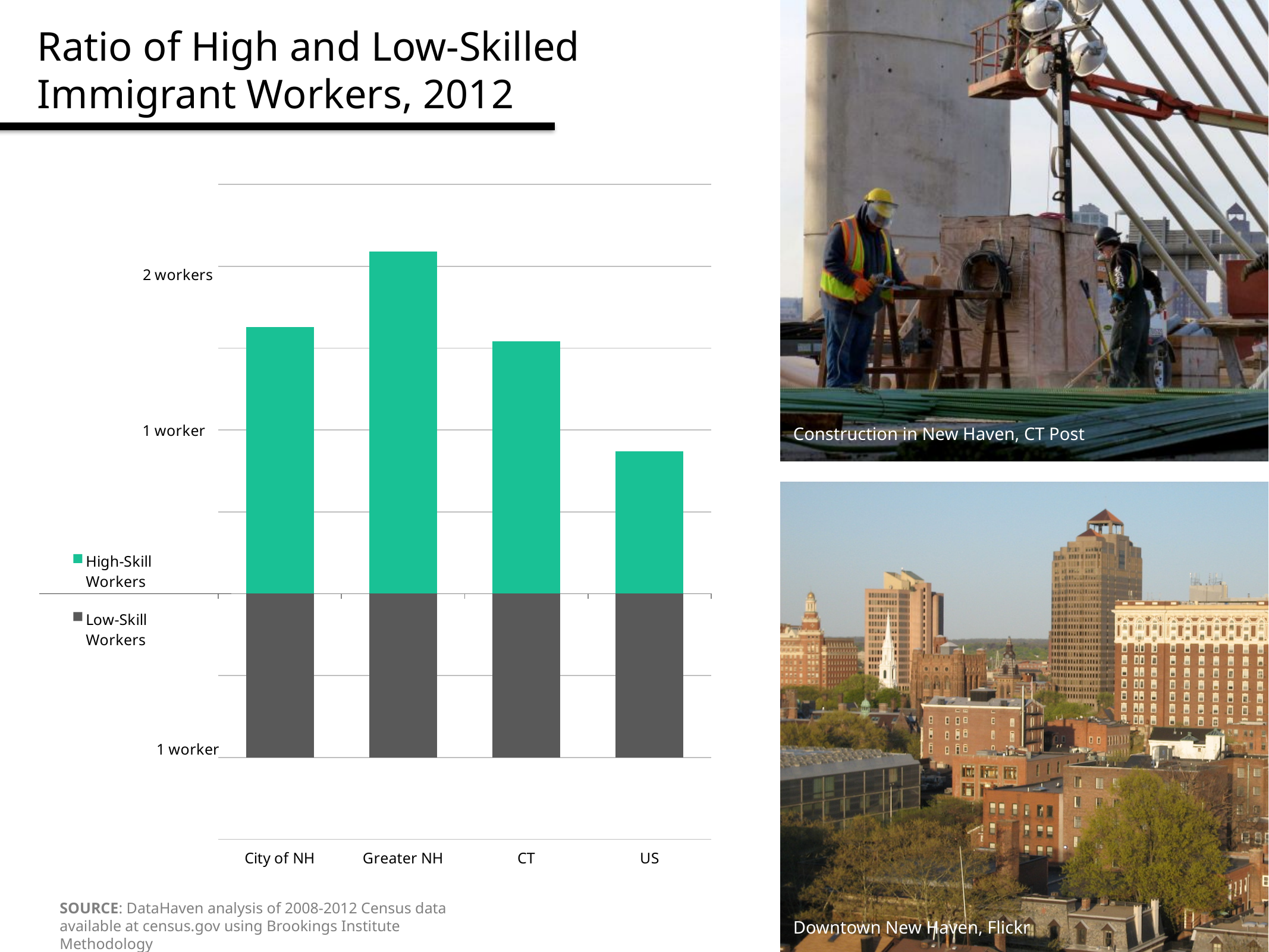
Is the High-Skill Workers value for US greater or less than 1 worker? less What is the Low-Skill Workers value for US? 1 worker How many series does the chart's legend list? 2 Which has a larger High-Skill Workers value, City of NH or US? City of NH Is the High-Skill Workers value for Greater NH greater or less than 2 workers? greater What kind of chart is shown on the slide? bar chart Is the High-Skill Workers value for City of NH greater or less than 1 worker? greater Which category has the highest High-Skill Workers value? Greater NH How many categories are shown on the x axis of the chart? 4 Which category has the lowest High-Skill Workers value? US Which colour represents High-Skill Workers in the chart? green Which has a larger High-Skill Workers value, Greater NH or CT? Greater NH